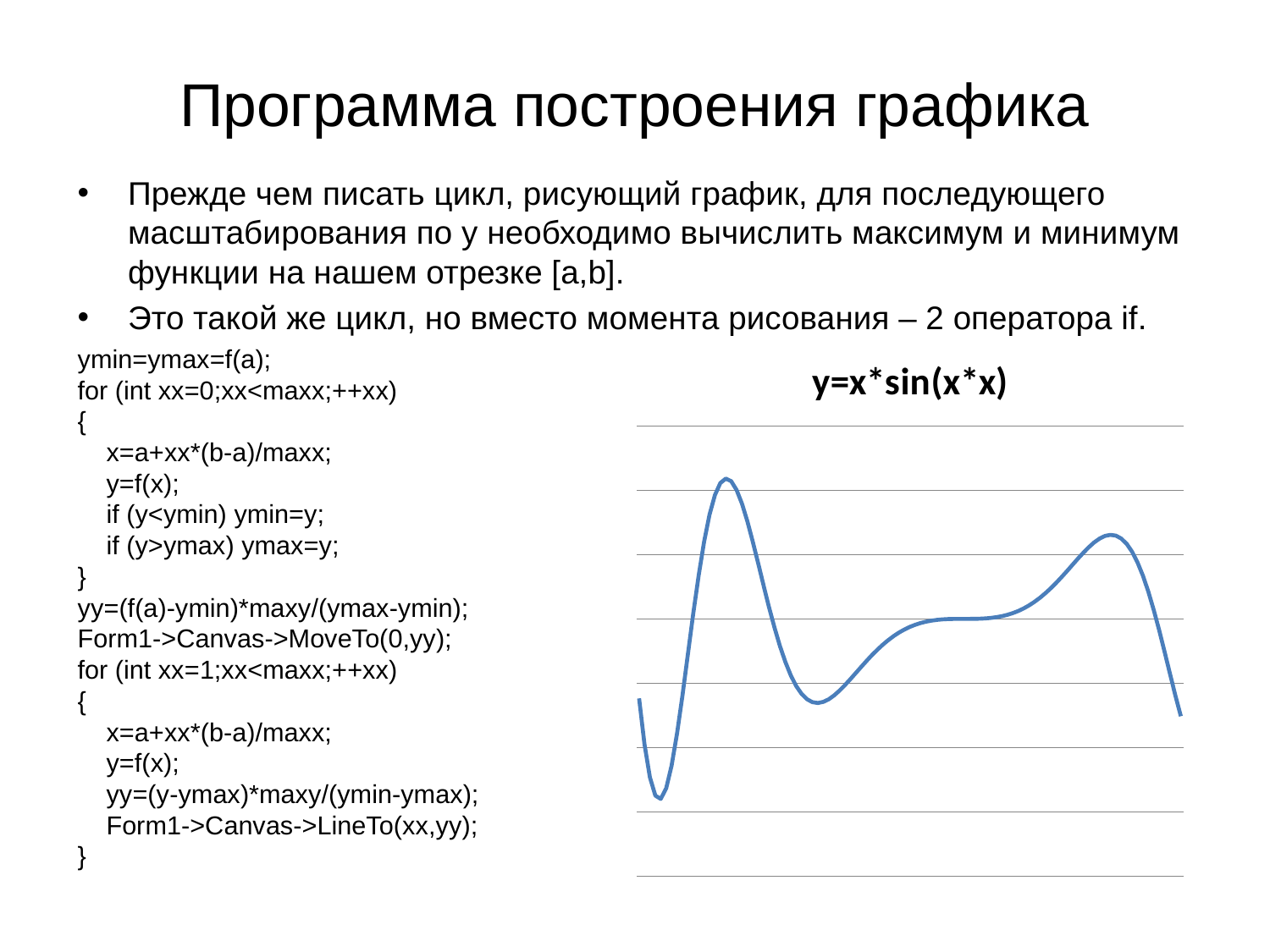
Which is higher on the chart: the first peak (on the left) or the second peak (on the right)? the first peak What is the title of the chart? y=x*sin(x*x) What colour is the line plotted in the chart? blue Does the line rise or fall immediately after its lowest point near the left edge? rise What kind of chart is shown on the slide? line chart Which is lower on the chart: the trough near the left edge or the trough in the middle of the chart? the trough near the left edge Does the line rise or fall at the right edge of the chart? fall